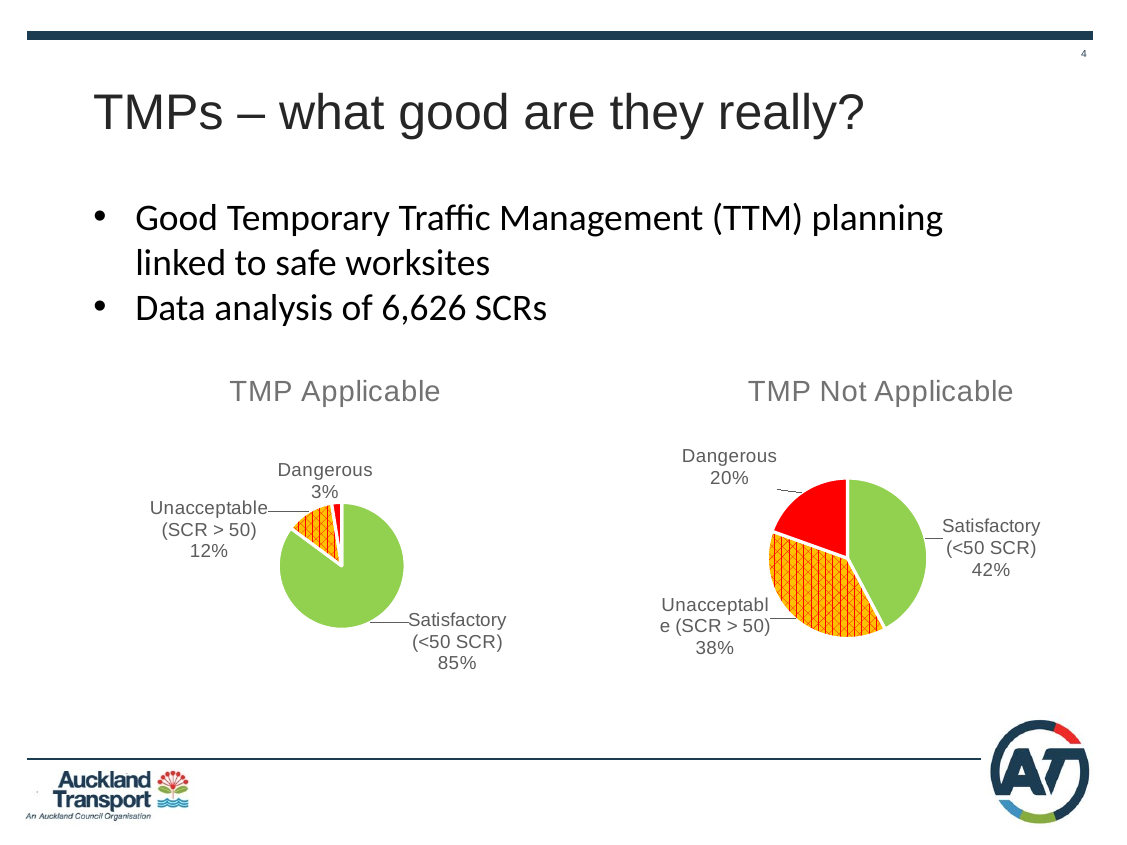
What type of chart is used for 'TMP Not Applicable'? Pie chart Which is larger: the Unacceptable (SCR > 50) share in the 'TMP Applicable' chart or in the 'TMP Not Applicable' chart? TMP Not Applicable In the 'TMP Not Applicable' pie chart, which category has the smallest share? Dangerous In the 'TMP Not Applicable' pie chart, what is the combined share of Unacceptable (SCR > 50) and Dangerous? 58% In the 'TMP Not Applicable' pie chart, what share is labelled for Dangerous? 20% What is the title of the pie chart on the left of the slide? TMP Applicable In the 'TMP Applicable' pie chart, which category has the largest share? Satisfactory (<50 SCR) In the 'TMP Applicable' pie chart, what share is labelled for Dangerous? 3% In the 'TMP Not Applicable' pie chart, what share is labelled for Unacceptable (SCR > 50)? 38% What is the difference in percentage points between the Dangerous share in the 'TMP Not Applicable' chart and the Dangerous share in the 'TMP Applicable' chart? 17 percentage points In the 'TMP Applicable' pie chart, what share is labelled for Satisfactory (<50 SCR)? 85% How many categories does the 'TMP Applicable' pie chart show? 3